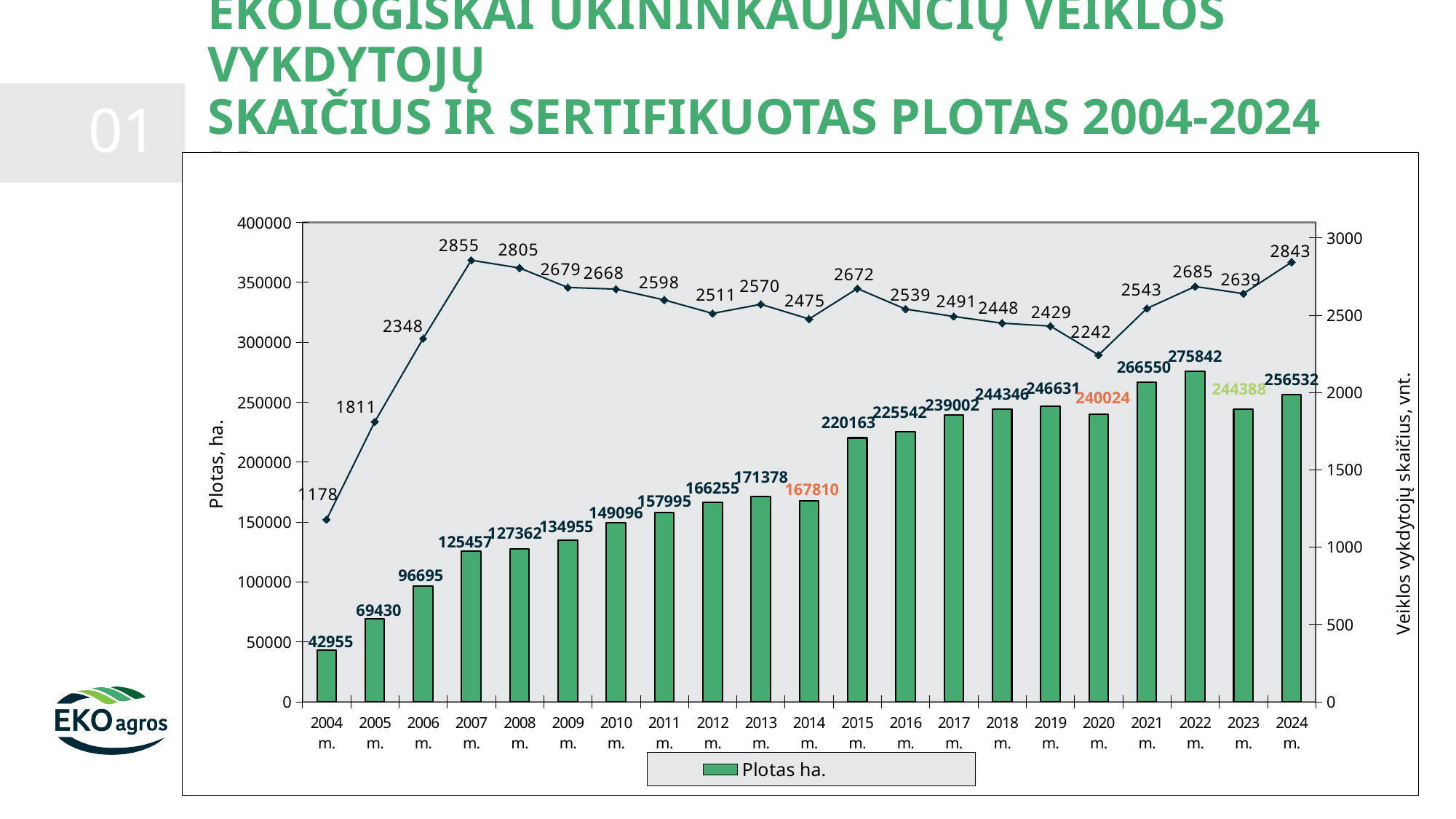
What is the label of the left vertical axis? Plotas, ha. Which is larger: the certified area in 2020 or in 2021? 2021 What is the certified area (Plotas ha.) for 2024? 256532 Which year has the lowest certified area bar? 2004 How many years are shown on the x axis? 21 Do the certified area bars generally rise or fall from 2004 to 2022? Rise Which year has the highest certified area bar? 2022 How many series does the legend list? 1 What kind of chart is this? Combined bar and line chart What is the difference between the certified area in 2022 and in 2023? 31454 Which year has the lowest value on the operator-count line? 2004 What is the number of operators (line series) shown for 2007? 2855